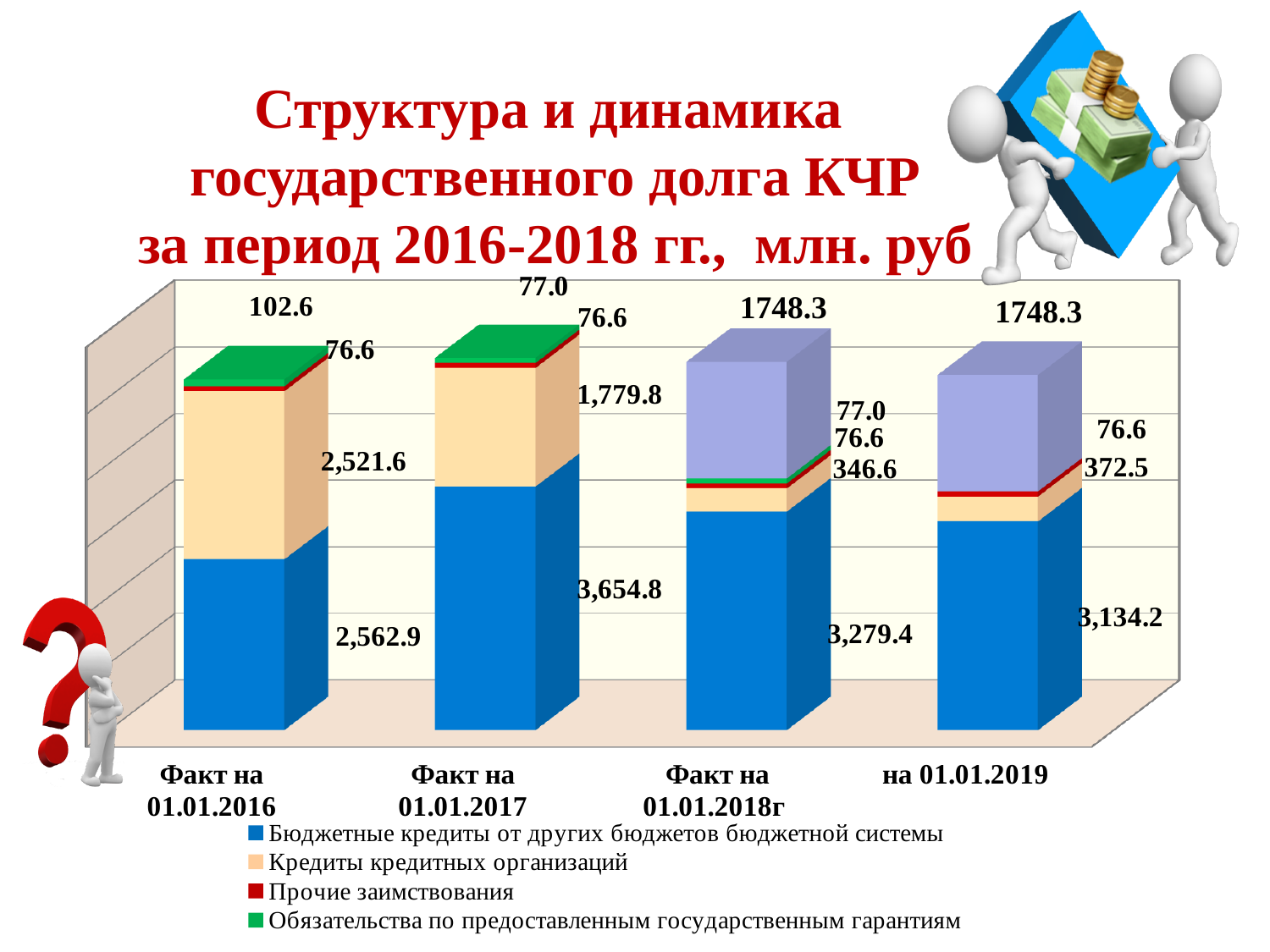
What is the value of Кредиты кредитных организаций for Факт на 01.01.2017? 1,779.8 Which is larger: Кредиты кредитных организаций for Факт на 01.01.2016 or for Факт на 01.01.2017? Факт на 01.01.2016 How many series does the chart legend list? 4 What is the total of the stacked bar for Факт на 01.01.2017 (sum of the four labelled segments)? 5,588.2 In which category is the value of Кредиты кредитных организаций the lowest? Факт на 01.01.2018г What is the value of Бюджетные кредиты от других бюджетов бюджетной системы for Факт на 01.01.2016? 2,562.9 What type of chart is shown on the slide? Stacked bar chart In which category is the value of Бюджетные кредиты от других бюджетов бюджетной системы the highest? Факт на 01.01.2017 How many categories are shown on the x axis of the chart? 4 What is the difference between the Бюджетные кредиты values for Факт на 01.01.2017 and Факт на 01.01.2016? 1,091.9 What is the value of Кредиты кредитных организаций for на 01.01.2019? 372.5 What is the value of Обязательства по предоставленным государственным гарантиям for Факт на 01.01.2016? 102.6